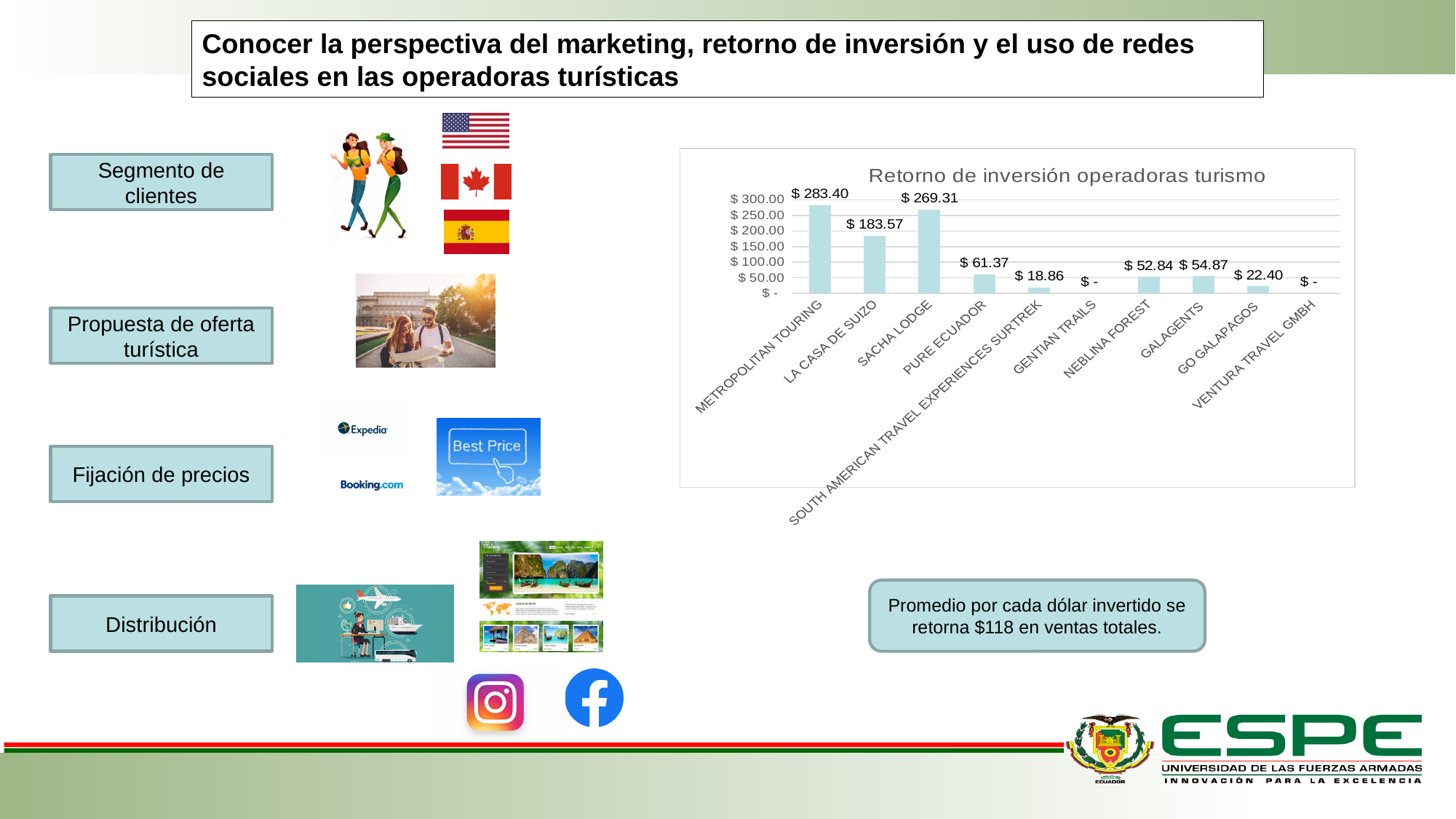
What is the title of the chart? Retorno de inversión operadoras turismo What is the difference between the values for METROPOLITAN TOURING and LA CASA DE SUIZO? $ 99.83 What is the value for SACHA LODGE in the chart? $ 269.31 Is the value for LA CASA DE SUIZO greater or less than $ 150.00? greater Which is larger, the value for NEBLINA FOREST or the value for GALAGENTS? GALAGENTS What kind of chart is shown on the slide? bar chart What is the value shown for GENTIAN TRAILS in the chart? $ - What is the value for METROPOLITAN TOURING in the chart? $ 283.40 How many operators are shown in the chart? 10 Which operator has the highest return on investment in the chart? METROPOLITAN TOURING What is the value for GO GALAPAGOS in the chart? $ 22.40 What is the value for PURE ECUADOR in the chart? $ 61.37